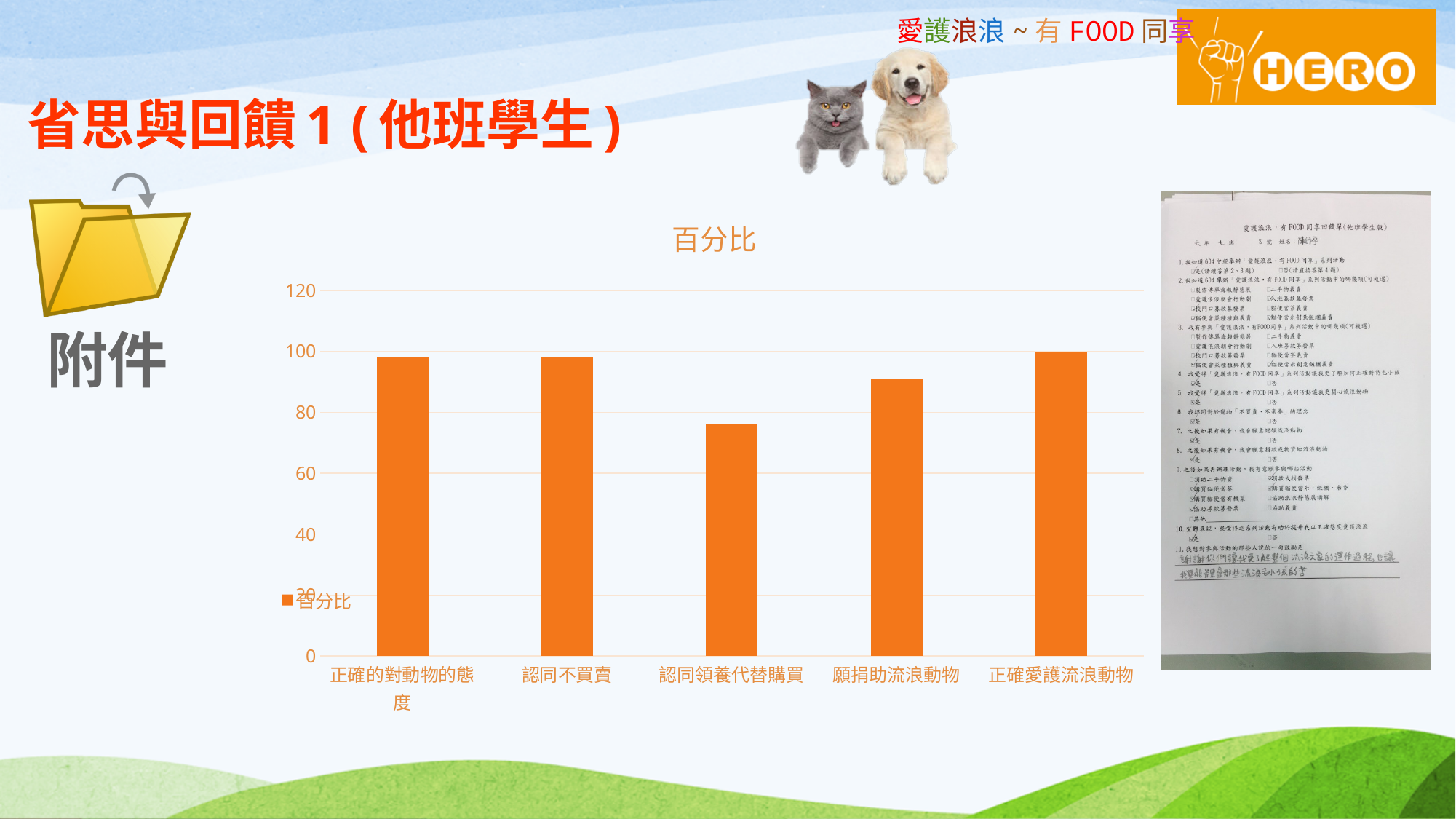
How many series does the chart legend list? 1 Is the value for 正確的對動物的態度 greater or less than 80? greater What is the legend entry shown for the chart? 百分比 How many categories are plotted in the chart? 5 Which is larger, the value for 認同不買賣 or the value for 認同領養代替購買? 認同不買賣 Is the value for 認同不買賣 greater or less than 60? greater Is the value for 認同領養代替購買 greater or less than 80? less Which is larger, the value for 願捐助流浪動物 or the value for 認同領養代替購買? 願捐助流浪動物 What kind of chart is shown on the slide? bar chart Which category has the lowest value in the chart? 認同領養代替購買 What is the title of the chart? 百分比